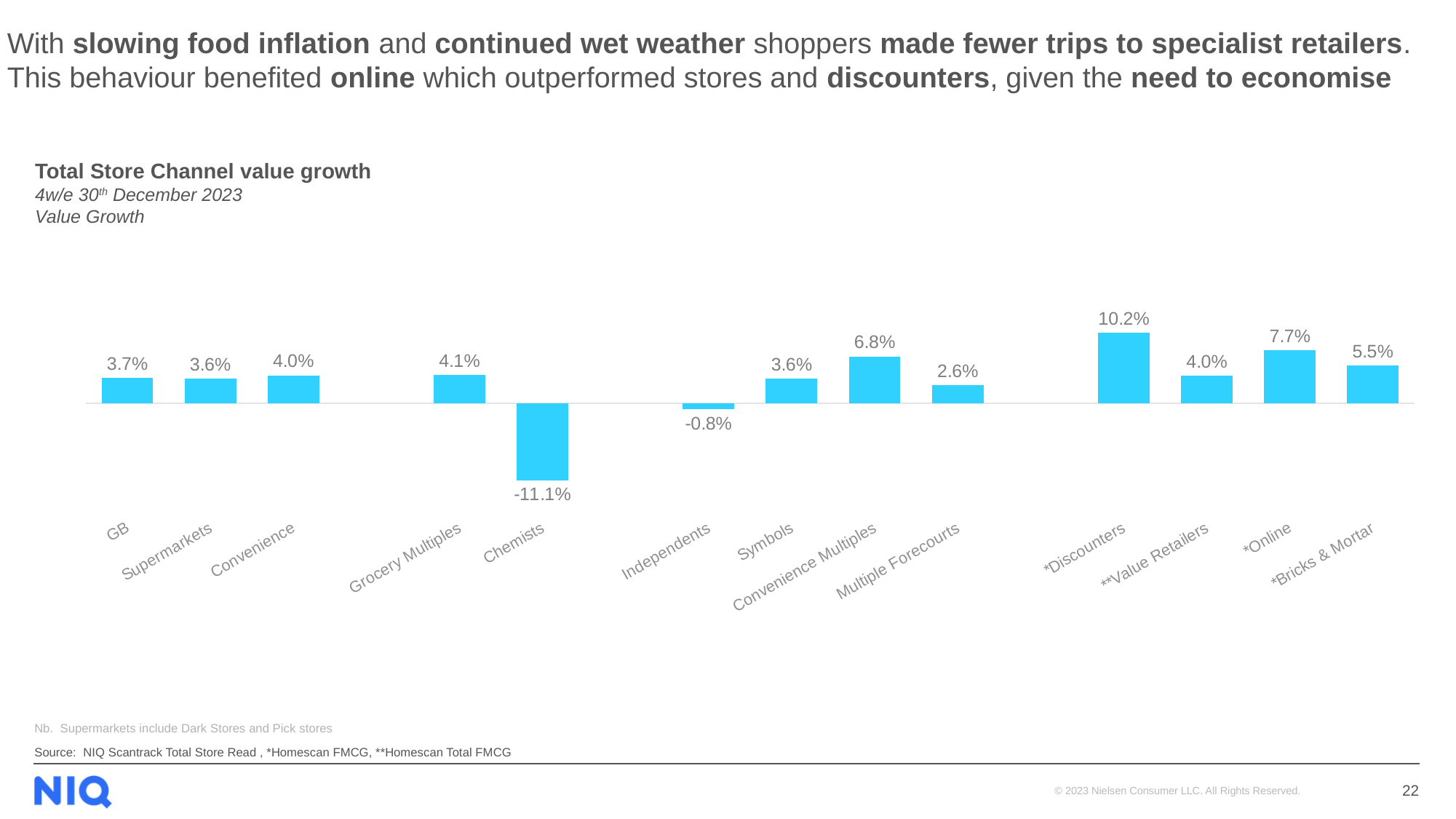
Which has higher value growth, Grocery Multiples or Multiple Forecourts? Grocery Multiples What type of chart is shown on the slide? Bar chart What is the difference in value growth between *Discounters and GB? 6.5% What is the value growth for Independents? -0.8% Which channel has the highest value growth? *Discounters What is the value growth for Chemists? -11.1% What is the value growth for *Discounters? 10.2% What is the title of the chart? Total Store Channel value growth What is the value growth for Convenience Multiples? 6.8% Which channel has the lowest value growth? Chemists How many channels are shown in the chart? 13 What is the difference in value growth between *Online and *Bricks & Mortar? 2.2%